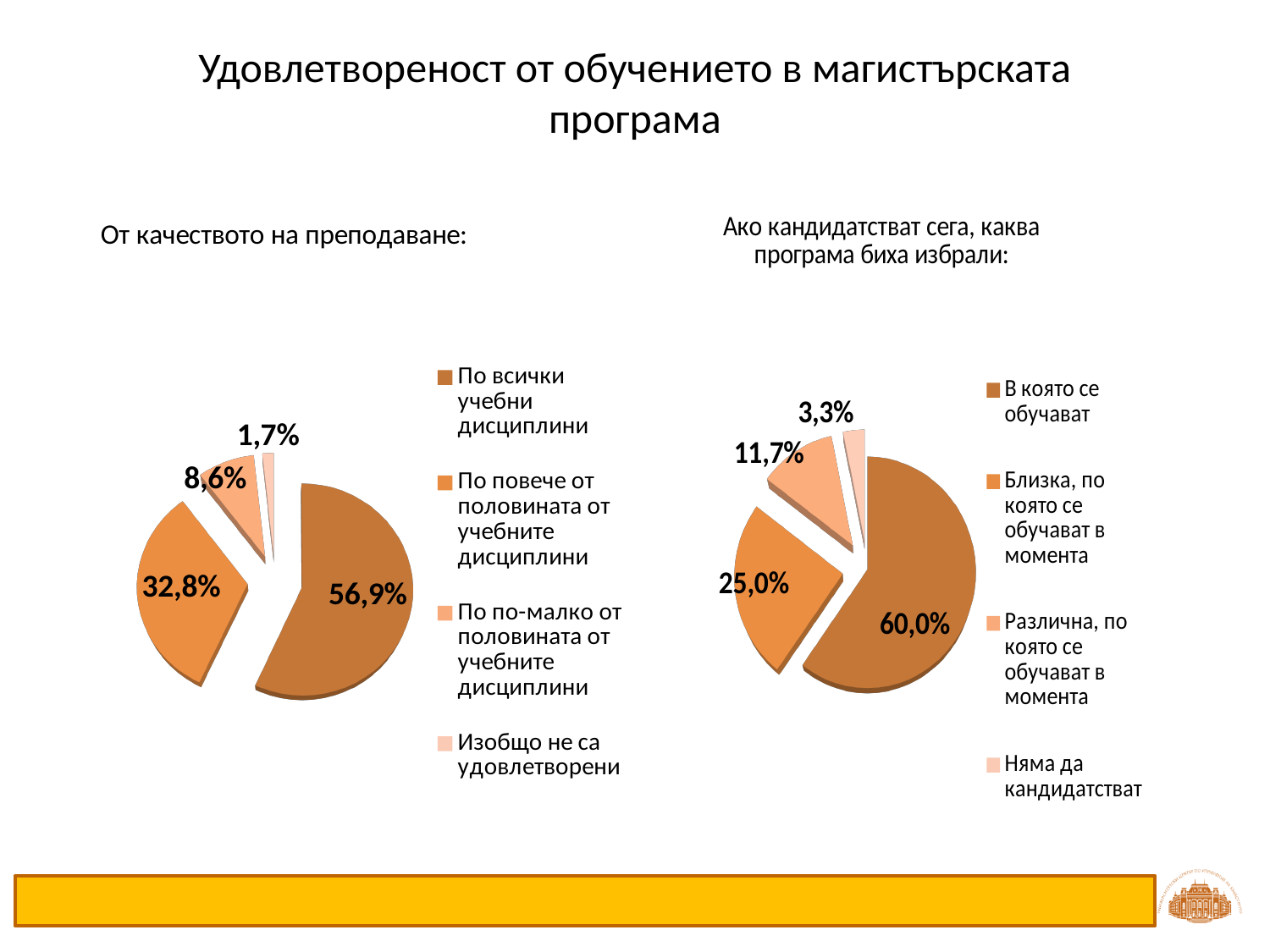
In the right pie chart (Ако кандидатстват сега, каква програма биха избрали), which category has the smallest slice? Няма да кандидатстват In the right pie chart (Ако кандидатстват сега, каква програма биха избрали), what share is labelled for 'Няма да кандидатстват'? 3,3% In the left pie chart (От качеството на преподаване), what share is labelled for 'По всички учебни дисциплини'? 56,9% In the left pie chart (От качеството на преподаване), which category has the largest slice? По всички учебни дисциплини In the left pie chart (От качеството на преподаване), what share is labelled for 'Изобщо не са удовлетворени'? 1,7% In the left pie chart (От качеството на преподаване), how many slices does the pie have? 4 In the right pie chart (Ако кандидатстват сега, каква програма биха избрали), which is larger: 'Близка, по която се обучават в момента' or 'Различна, по която се обучават в момента'? Близка, по която се обучават в момента In the right pie chart (Ако кандидатстват сега, каква програма биха избрали), what share is labelled for 'В която се обучават'? 60,0% In the left pie chart (От качеството на преподаване), which category has the smallest slice? Изобщо не са удовлетворени In the right pie chart (Ако кандидатстват сега, каква програма биха избрали), what is the difference between the 'В която се обучават' slice and the 'Близка, по която се обучават в момента' slice? 35,0% What type of chart is used for both charts on the slide? Pie chart In the left pie chart (От качеството на преподаване), what is the difference between the 56,9% slice and the 32,8% slice? 24,1%